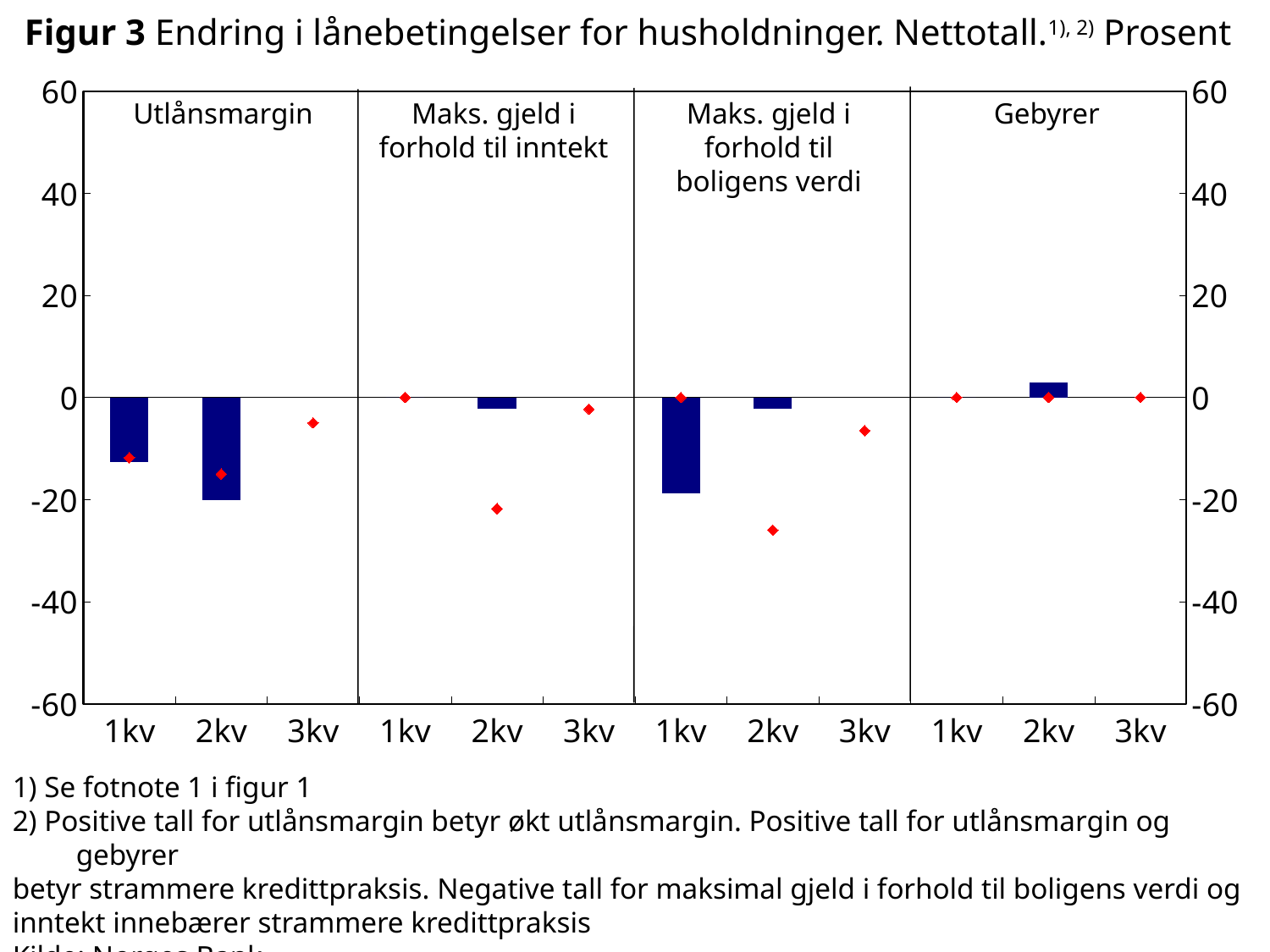
Is the red marker for 2kv in the 'Maks. gjeld i forhold til boligens verdi' panel greater or less than -20? less Is the bar for 1kv in the 'Maks. gjeld i forhold til boligens verdi' panel greater or less than -10? less Is the bar for 2kv in the Gebyrer panel greater or less than 0? greater What kind of chart is shown on the slide? bar chart with red diamond markers (combination bar and marker chart) In the Utlånsmargin panel, which bar is lower, 1kv or 2kv? 2kv What colour are the bars in the chart? dark blue How many panels (loan condition categories) does the chart have? 4 Which panel contains the only bar with a positive value? Gebyrer What is the figure number given in the chart title? Figur 3 How many quarters are shown on the x axis within each panel? 3